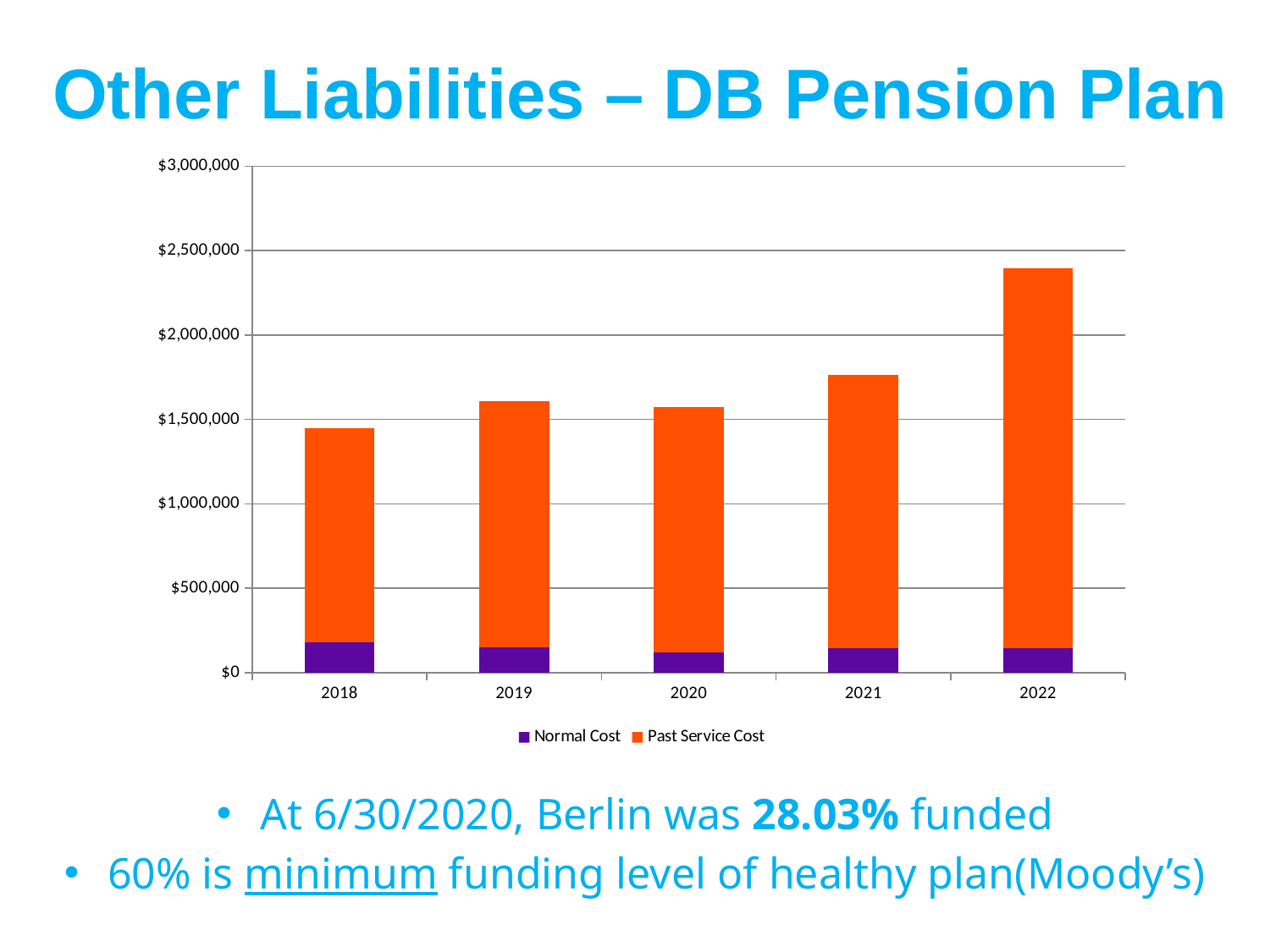
Which year has the tallest total bar in the chart? 2022 Is the Normal Cost segment for 2018 greater or less than $500,000? less Which year has the larger total bar, 2021 or 2019? 2021 Is the total bar for 2021 greater or less than $2,000,000? less Which year has the shortest total bar in the chart? 2018 Which series is shown in orange in the chart? Past Service Cost What kind of chart is shown on the slide? stacked bar chart How many years are shown on the x axis of the chart? 5 Is the total bar for 2018 greater or less than $1,500,000? less How many series does the chart's legend list? 2 Which series is shown in purple in the chart? Normal Cost